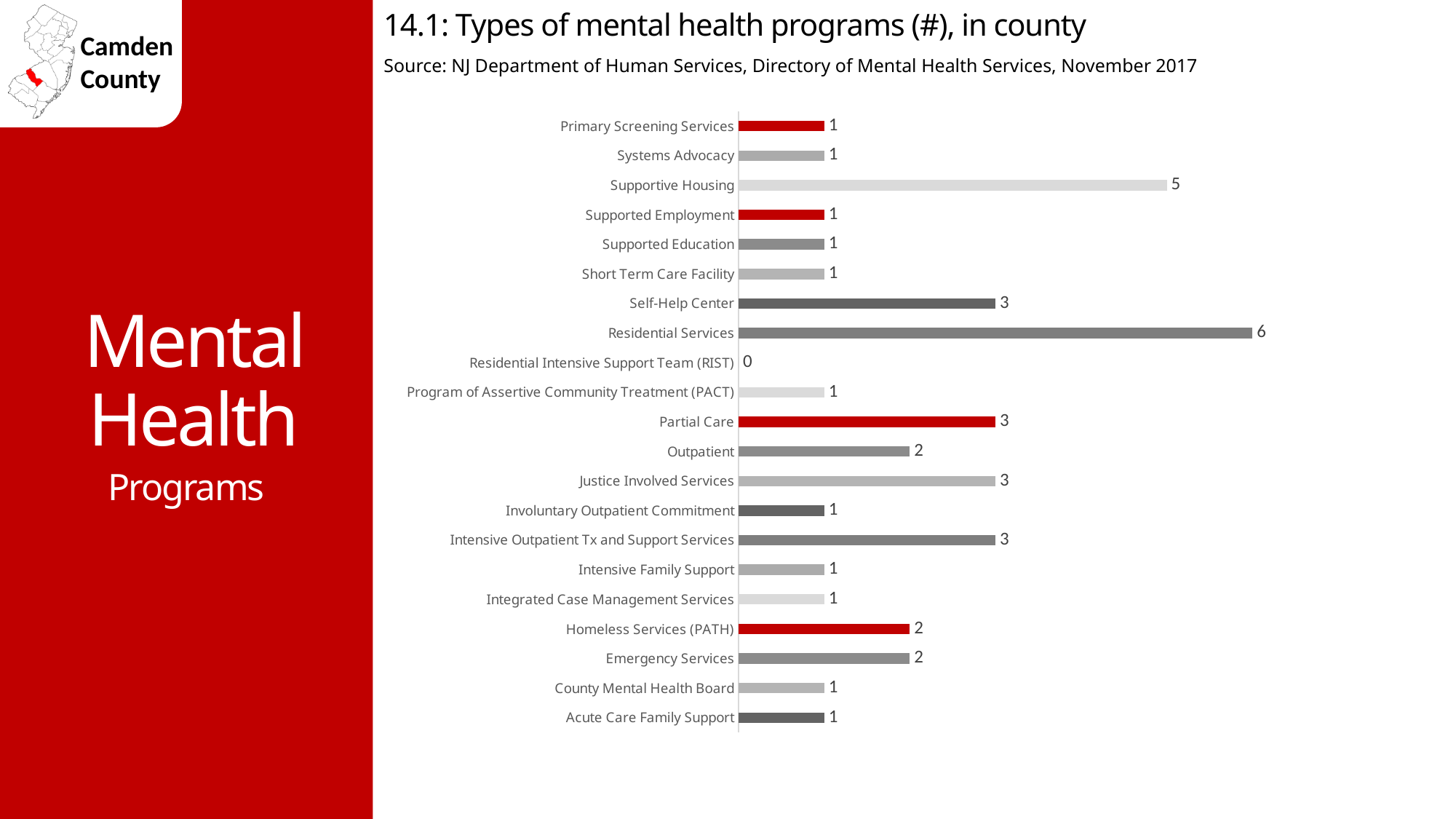
What is the difference between the number of Partial Care programs and the number of Outpatient programs? 1 What value is shown for Residential Intensive Support Team (RIST)? 0 How many types of mental health programs are listed in the chart? 21 Which type of mental health program has the lowest count in the chart? Residential Intensive Support Team (RIST) How many Supportive Housing programs are shown in the chart? 5 Which type of mental health program has the highest count in the chart? Residential Services What is the title of the chart on this slide? 14.1: Types of mental health programs (#), in county What is the difference between the number of Residential Services programs and the number of Supportive Housing programs? 1 What is the number of Residential Services programs shown in the chart? 6 How many Outpatient programs are shown in the chart? 2 What kind of chart is used on this slide? Bar chart Which has more programs, Self-Help Center or Homeless Services (PATH)? Self-Help Center